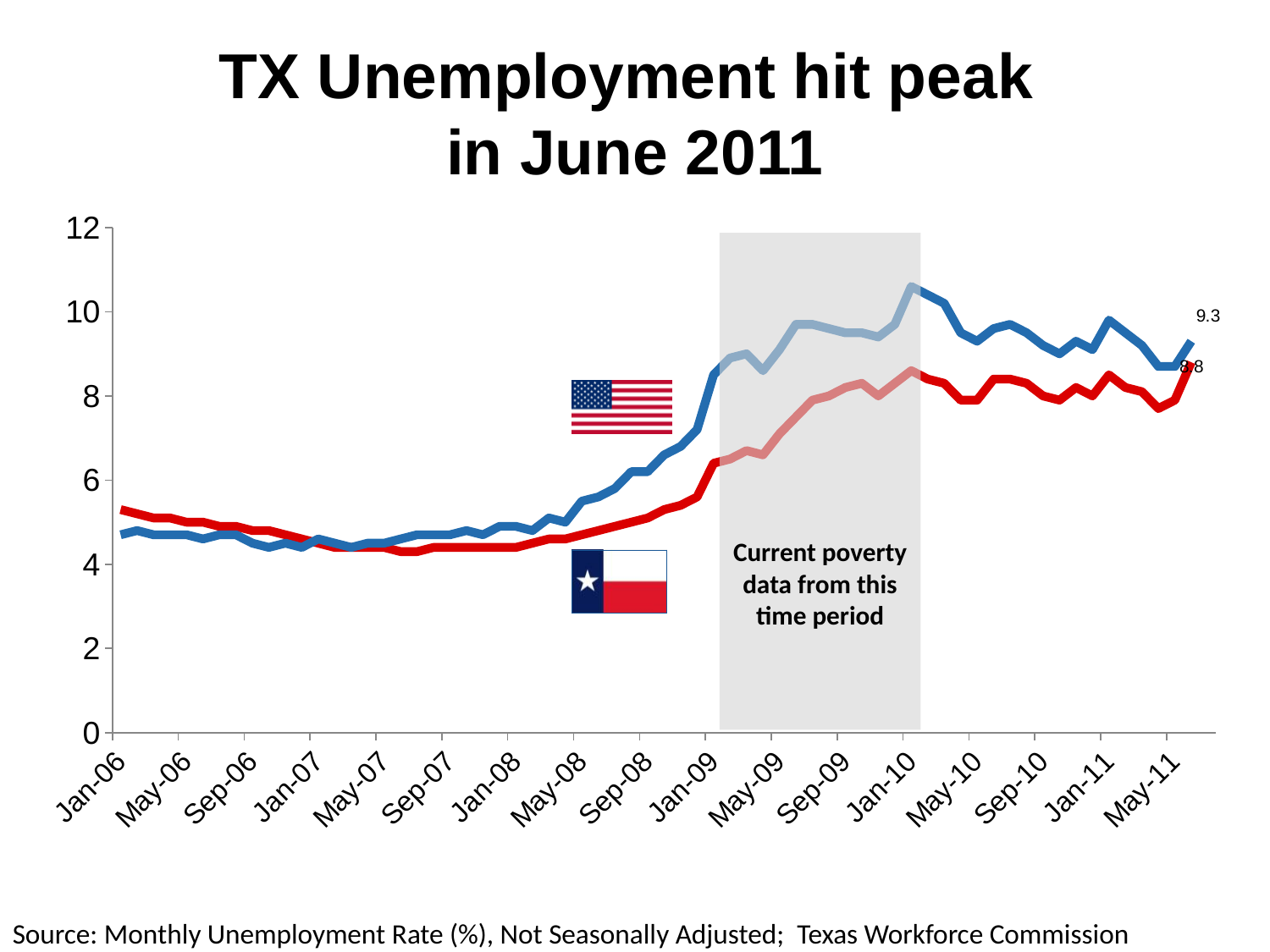
What is the final labelled value of the blue line (marked with the US flag)? 9.3 What is the title of the slide's chart? TX Unemployment hit peak in June 2011 Is the value of the blue (US) line at its peak around Jan-10 greater or less than 10? greater What is the final labelled value of the red line (marked with the Texas flag)? 8.8 Is the value of the red (Texas) line at Jan-06 greater or less than 6? less What kind of chart is shown on the slide? line chart Does the red (Texas) line rise or fall between Jan-08 and Jan-10? rise How many lines (series) are plotted on the chart? 2 Is the value of the red (Texas) line at Jan-10 greater or less than 8? greater At the end of the chart, which line has the higher labelled value, the blue (US) line or the red (Texas) line? the blue (US) line What is the difference between the final labelled values of the blue line (9.3) and the red line (8.8)? 0.5 What does the text inside the grey shaded region of the chart say? Current poverty data from this time period